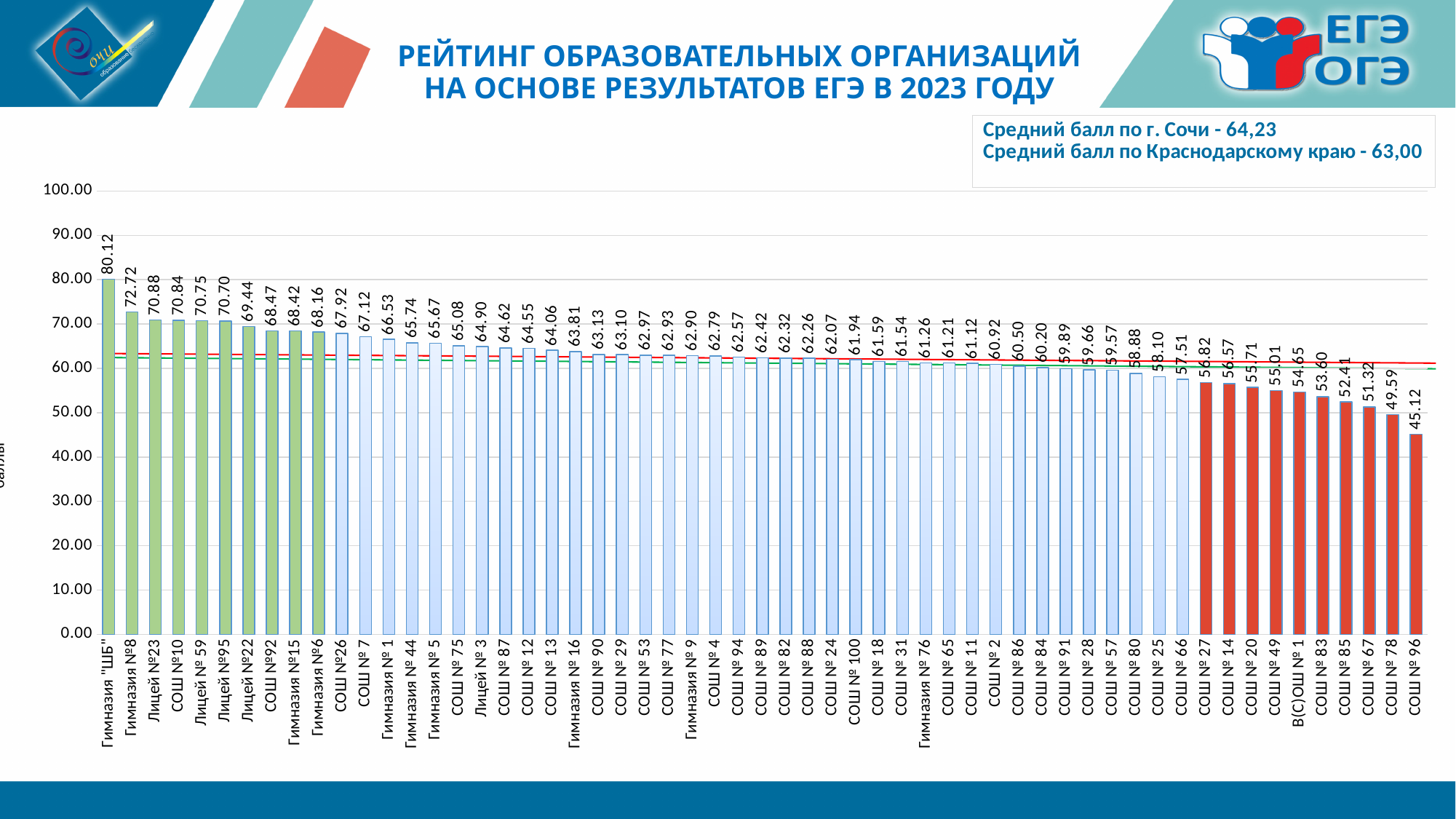
What is the difference between the values for Гимназия "ШБ" and Гимназия №8? 7.40 What is the value for Лицей № 3? 64.90 Is the value for СОШ № 67 greater or less than 60.00? less What kind of chart is shown on the slide? bar chart What is the value for СОШ № 96? 45.12 Which organisation has the highest value? Гимназия "ШБ" Do the values rise or fall from left to right along the x axis? fall What is the value for В(С)ОШ № 1? 54.65 Which organisation has the lowest value? СОШ № 96 How many organisations are shown on the chart? 57 What is the value for Гимназия "ШБ"? 80.12 Which has a larger value, СОШ №26 or СОШ № 78? СОШ №26